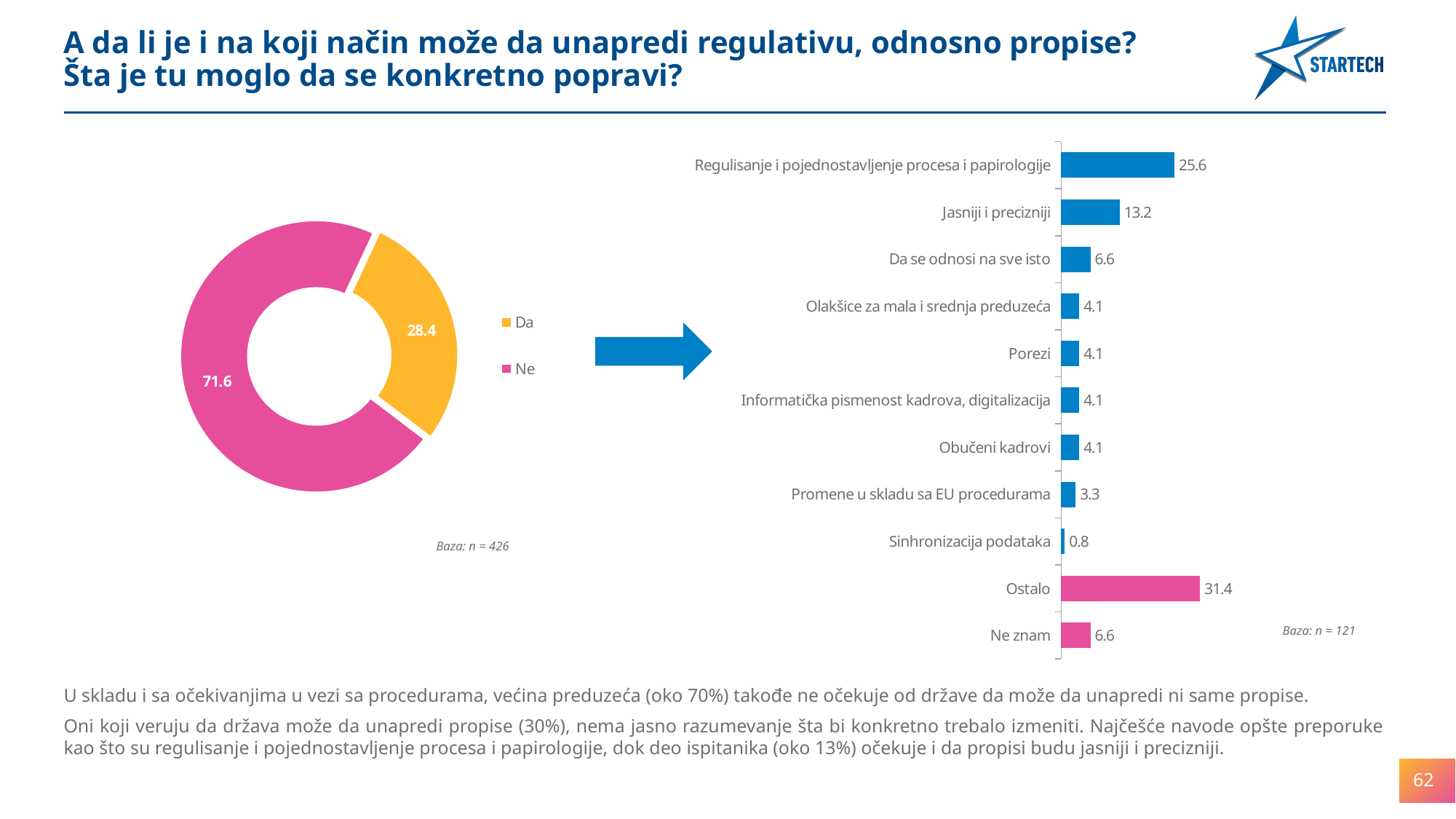
In the pie chart on the left, which category has the larger share, "Da" or "Ne"? Ne What kind of chart is the chart on the right of the slide? Bar chart In the bar chart on the right, what is the difference between "Regulisanje i pojednostavljenje procesa i papirologije" and "Jasniji i precizniji"? 12.4 In the bar chart on the right, what is the value for "Jasniji i precizniji"? 13.2 How many categories are shown in the bar chart on the right? 11 In the bar chart on the right, what is the value for "Regulisanje i pojednostavljenje procesa i papirologije"? 25.6 What kind of chart is the chart on the left of the slide? Pie chart (donut) In the pie chart on the left, what is the value for "Da"? 28.4 In the bar chart on the right, which category has the highest value? Ostalo How many entries does the legend of the pie chart on the left list? 2 In the pie chart on the left, what is the value for "Ne"? 71.6 In the bar chart on the right, which category has the lowest value? Sinhronizacija podataka